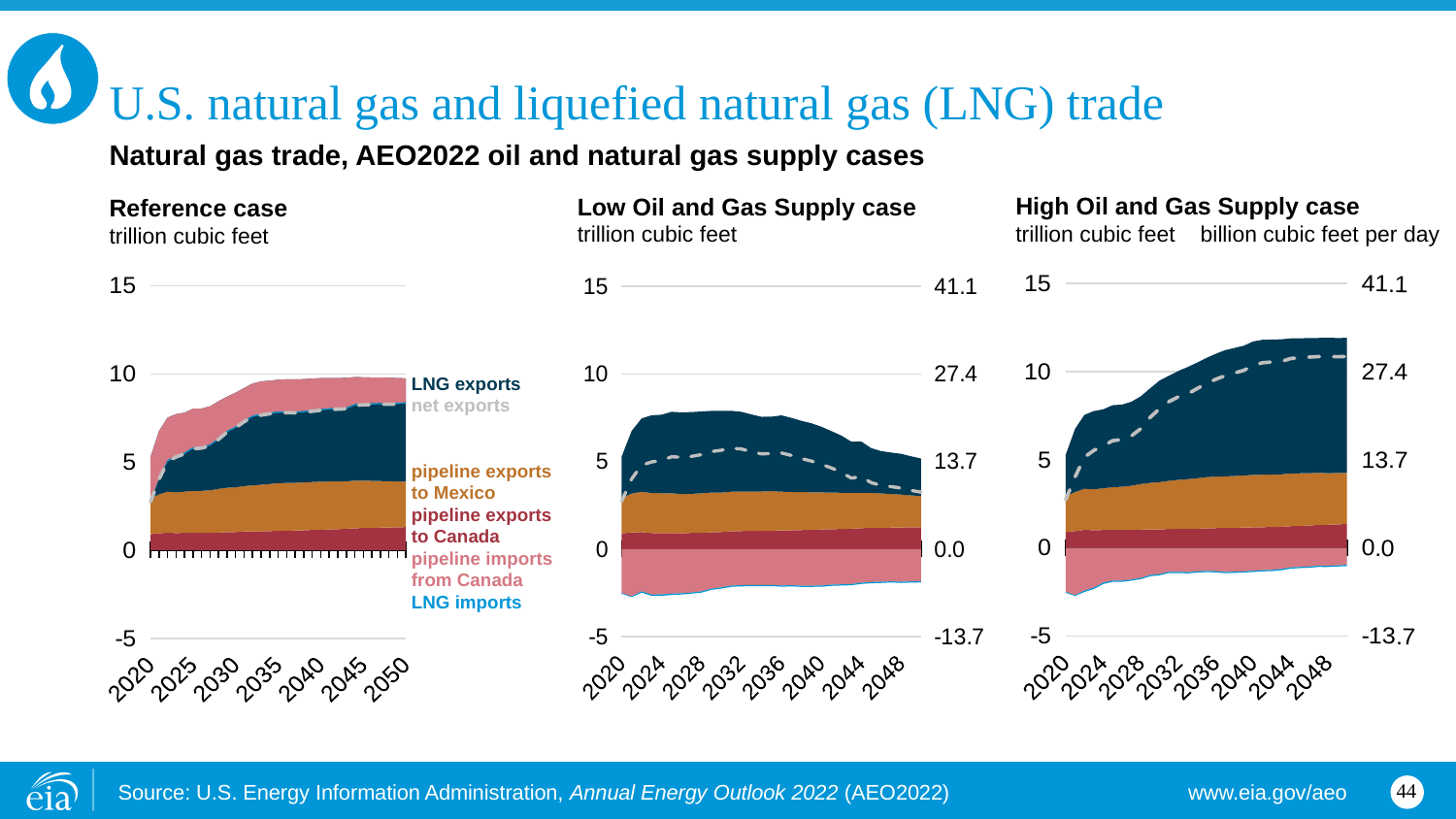
In the Low Oil and Gas Supply case chart, is the top of the stacked exports in 2028 greater or less than 5? greater In the High Oil and Gas Supply case chart, do net exports rise or fall from 2020 to 2048? rise In the Low Oil and Gas Supply case chart, do net exports rise or fall from 2036 to 2048? fall What unit is shown on the right-hand axis of the High Oil and Gas Supply case chart? billion cubic feet per day In the Reference case chart, is the net exports value in 2050 greater or less than 10? less How many charts are shown on the slide? 3 What is the highest tick value on the right-hand axis of the Low Oil and Gas Supply case chart? 41.1 Which chart shows the larger net exports value in 2048, the Low Oil and Gas Supply case or the High Oil and Gas Supply case? High Oil and Gas Supply case In the Reference case chart, is the net exports value in 2050 greater or less than 5? greater What kind of chart is the Reference case chart? stacked area chart How many entries does the legend next to the Reference case chart list? 6